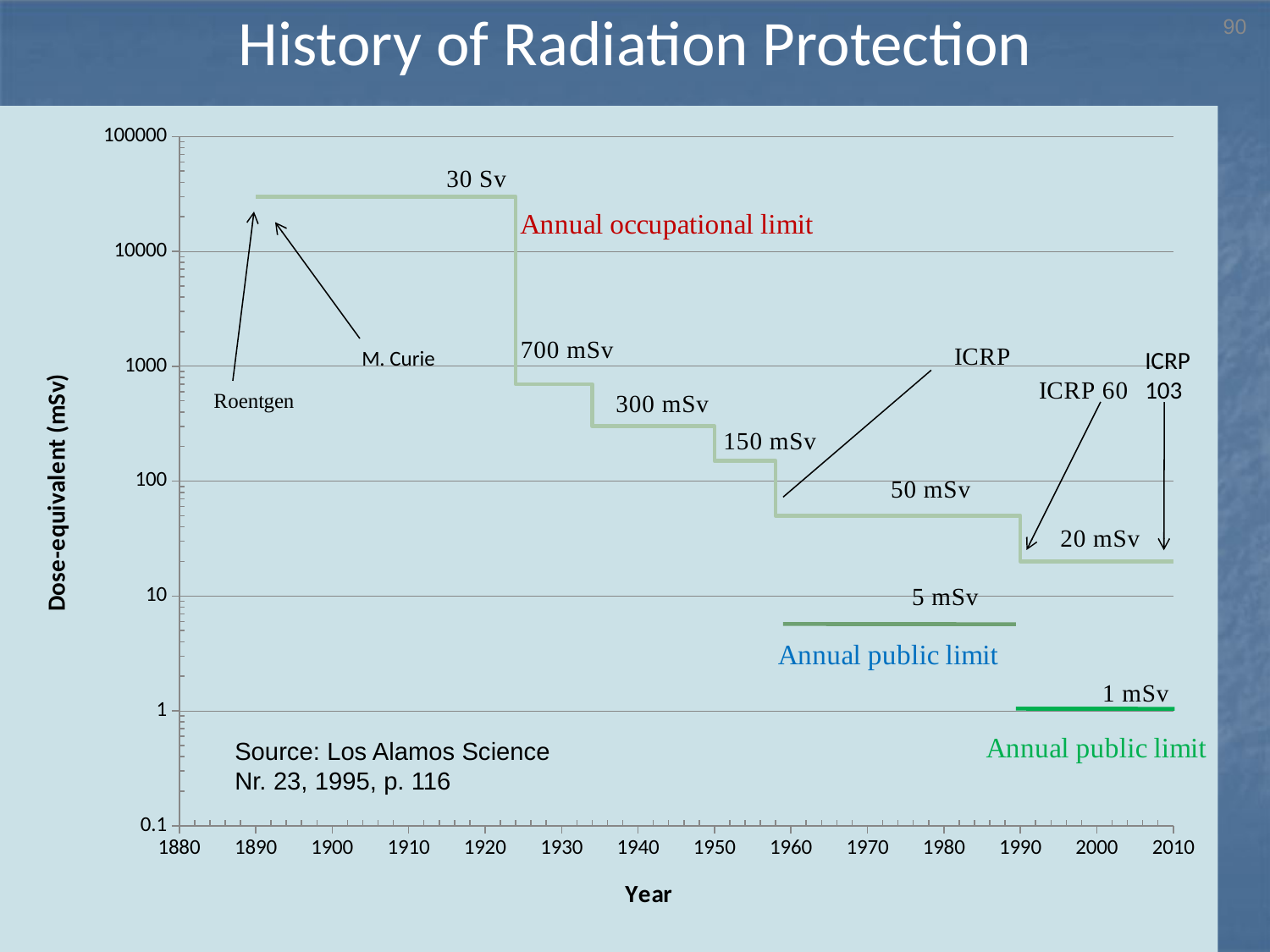
What annual occupational limit is labelled on the chart from about 1990 onward? 20 mSv What annual occupational limit is labelled on the chart for the step beginning around 1925? 700 mSv What kind of chart is shown on the slide? line chart What annual public limit is labelled on the chart from about 1990 onward? 1 mSv What is the annual occupational limit labelled on the chart for the earliest period, starting around 1890? 30 Sv What annual occupational limit is labelled on the chart for the step beginning around 1935? 300 mSv What is the title of the chart on the slide? History of Radiation Protection What is the label of the vertical axis? Dose-equivalent (mSv) Does the annual occupational limit rise or fall over time along the x axis? fall What annual occupational limit is labelled on the chart for the period from about 1958 to 1990? 50 mSv What annual public limit is labelled on the chart for the period from about 1960 to 1990? 5 mSv What annual occupational limit is labelled on the chart for the step beginning around 1950? 150 mSv